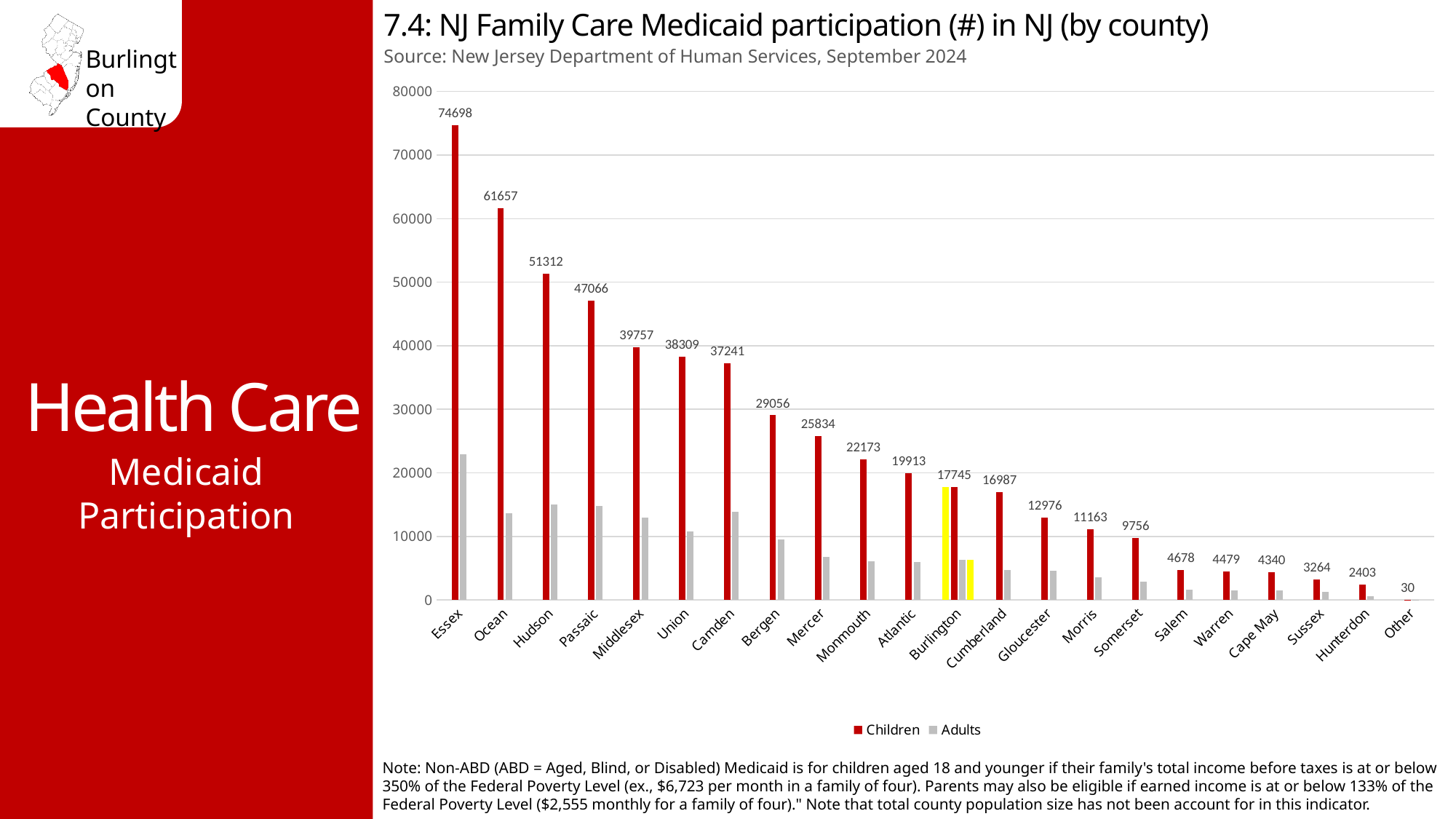
What kind of chart is shown on the slide? Bar chart How many categories are shown on the x axis? 22 Which county has the highest Children value? Essex How many series does the legend list? 2 Which category has the lowest Children value? Other What is the Children value for Hunterdon? 2403 What is the difference between the Children values for Ocean and Hudson? 10345 Is the Adults value for Essex greater or less than 20000? greater Which has a larger Children value, Bergen or Mercer? Bergen What is the Children value for Burlington? 17745 What is the Children value for Essex? 74698 Is the Adults value for Morris greater or less than 10000? less